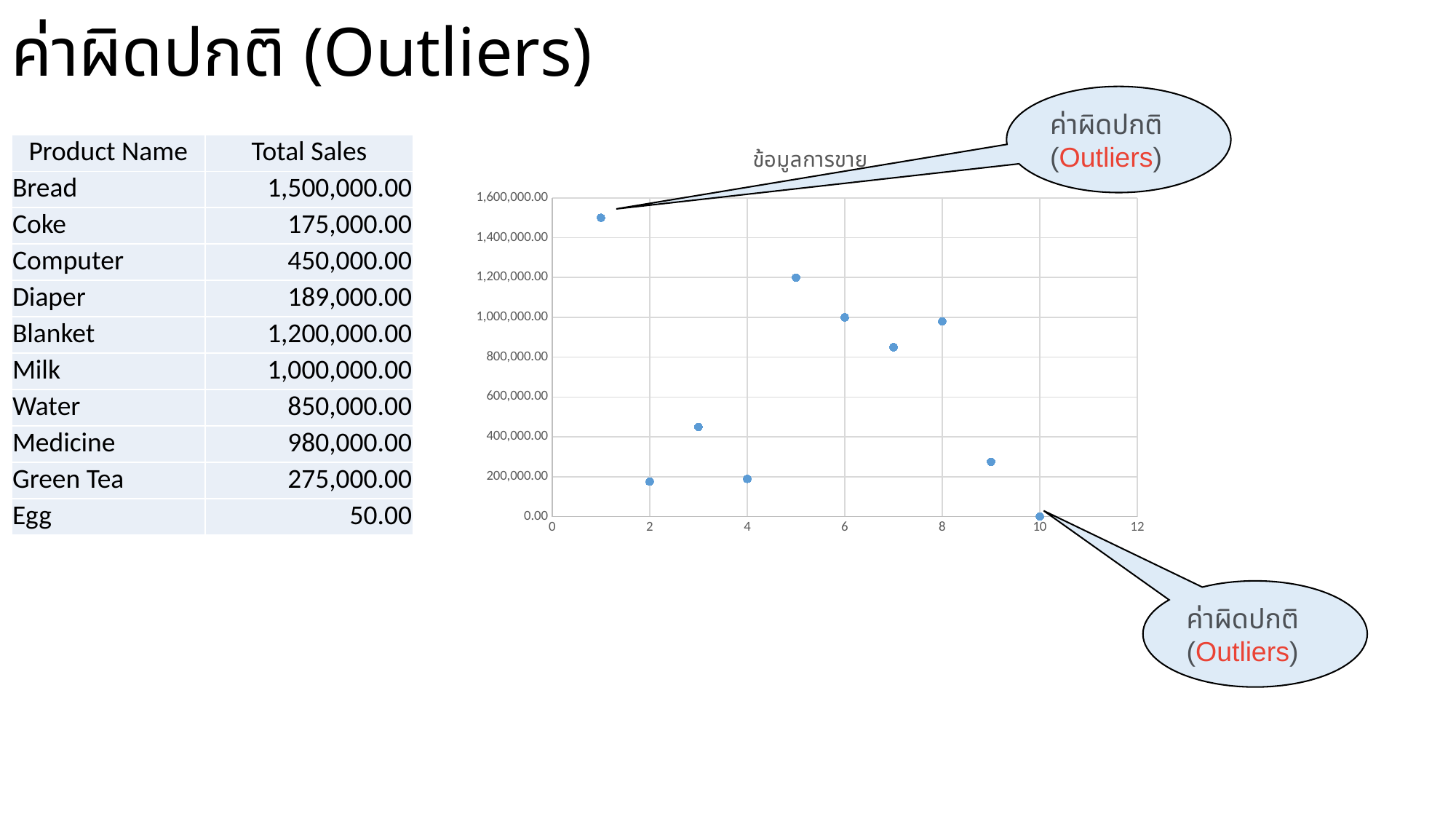
In the chart, which x position has the highest point? 1 What is the title of the chart? ข้อมูลการขาย What is the highest value shown on the chart's y axis? 1,600,000.00 In the chart, is the value of the point at x = 9 greater or less than 200,000.00? greater In the chart, is the value of the point at x = 1 greater or less than 1,400,000.00? greater In the chart, what is the y value of the point at x = 6? 1,000,000.00 In the chart, which x position has the lowest point? 10 In the chart, which point is higher: the one at x = 3 or the one at x = 7? x = 7 How many data points are plotted in the chart? 10 What kind of chart is shown on the slide? scatter chart In the chart, what is the y value of the point at x = 5? 1,200,000.00